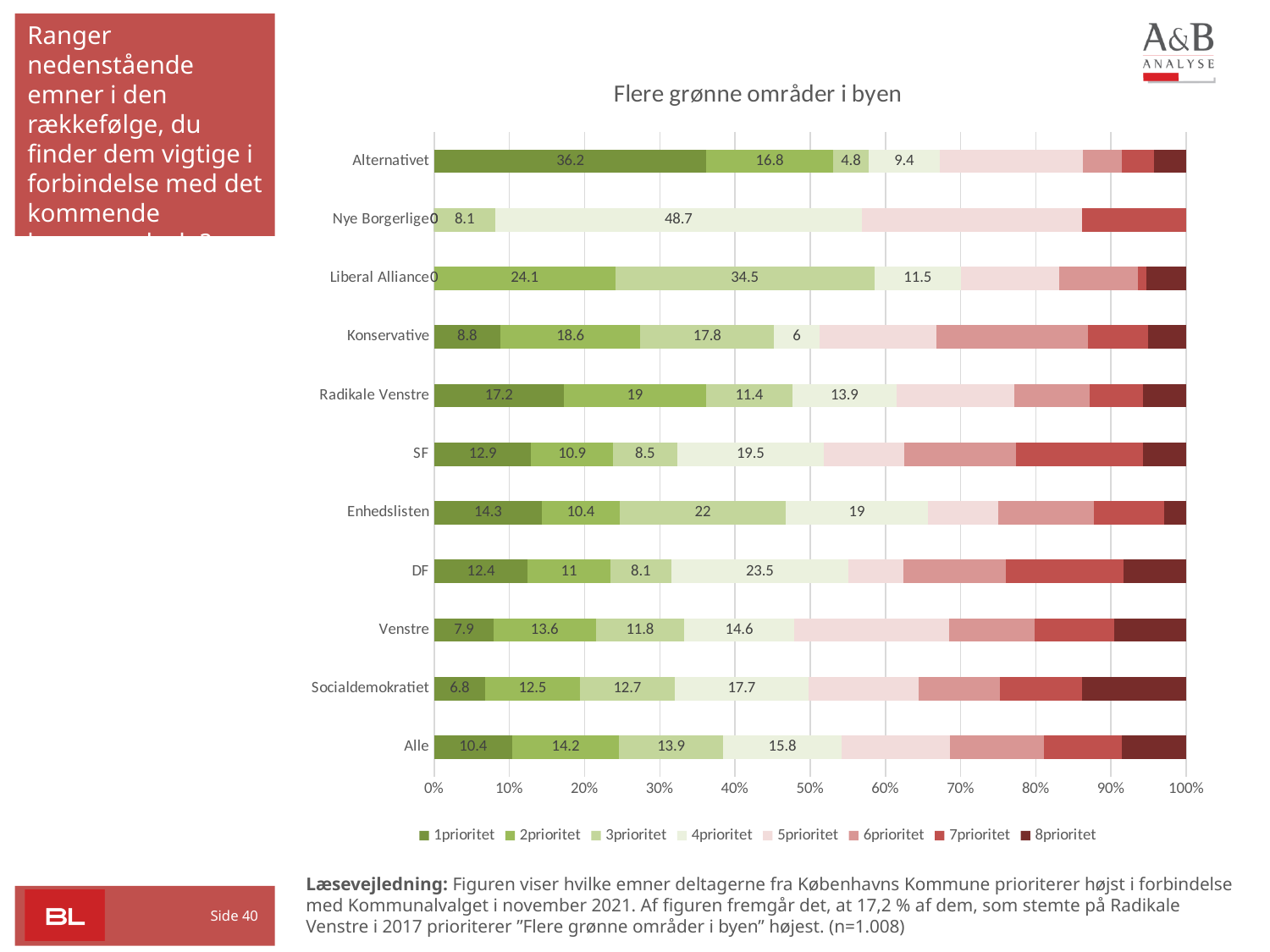
What is the 1prioritet value for Alternativet? 36.2 What is the 3prioritet value for Liberal Alliance? 34.5 What is the title of the chart? Flere grønne områder i byen How many categories are shown on the y axis? 11 What is the 4prioritet value for Nye Borgerlige? 48.7 Which category has the highest 1prioritet value? Alternativet What is the 1prioritet value for Radikale Venstre? 17.2 What is the difference between the 1prioritet values for Alternativet and Radikale Venstre? 19 What kind of chart is shown? Stacked bar chart Which category has the lowest 4prioritet value? Konservative Which is larger, the 2prioritet value for Liberal Alliance or the 2prioritet value for Konservative? Liberal Alliance How many series does the legend list? 8